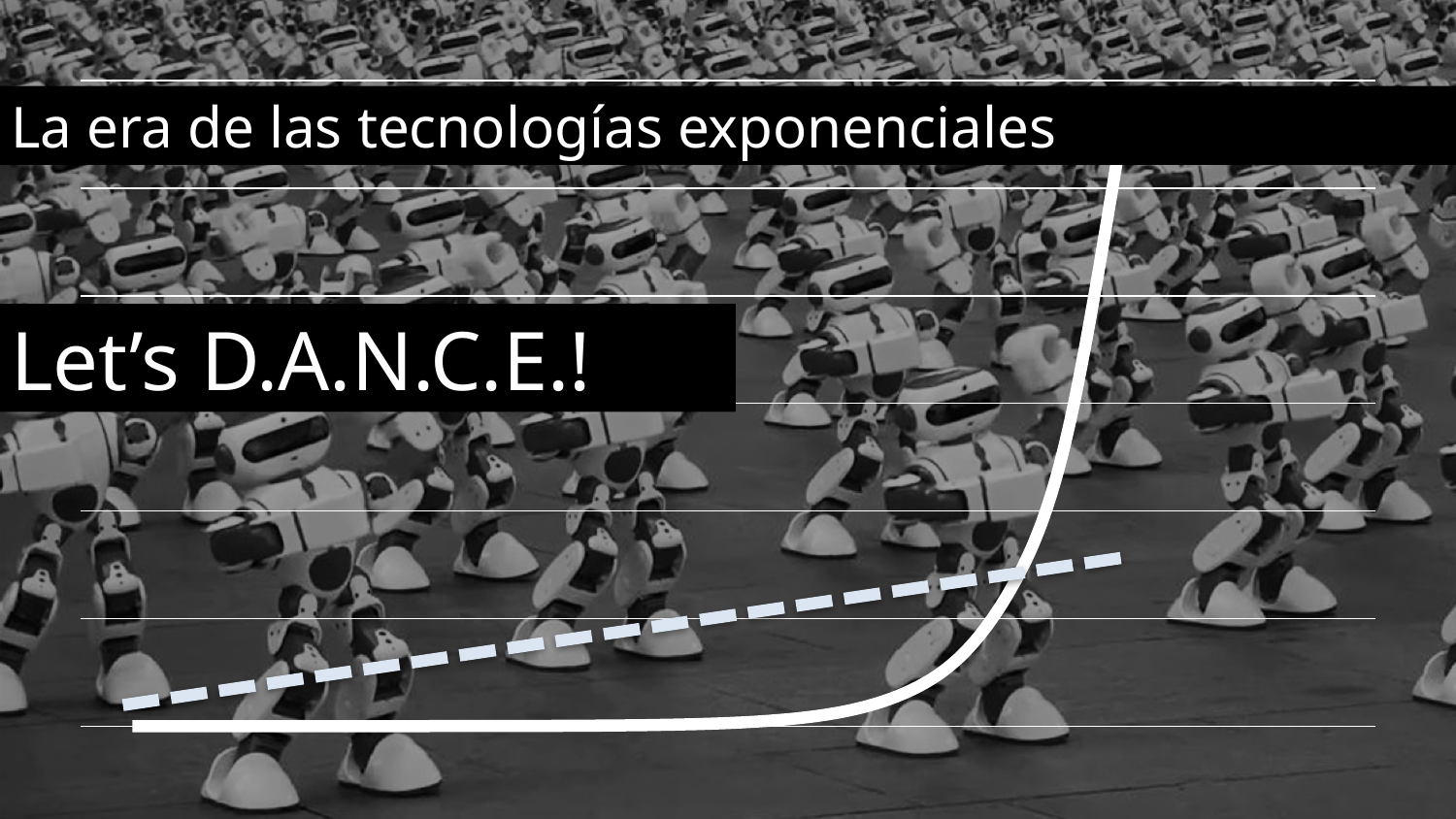
What kind of chart is shown on the slide? line chart Which line is higher at the left end of the chart, the solid line or the dashed line? the dashed line How many lines are plotted on the chart? 2 Does the solid white line rise or fall from left to right? rise Does the dashed line rise or fall from left to right? rise Which of the two lines is drawn as a dashed line? the straight (linear) line Which line reaches a higher value at the right end of the chart, the solid line or the dashed line? the solid line Which of the two lines shows an exponential shape, the solid line or the dashed line? the solid line